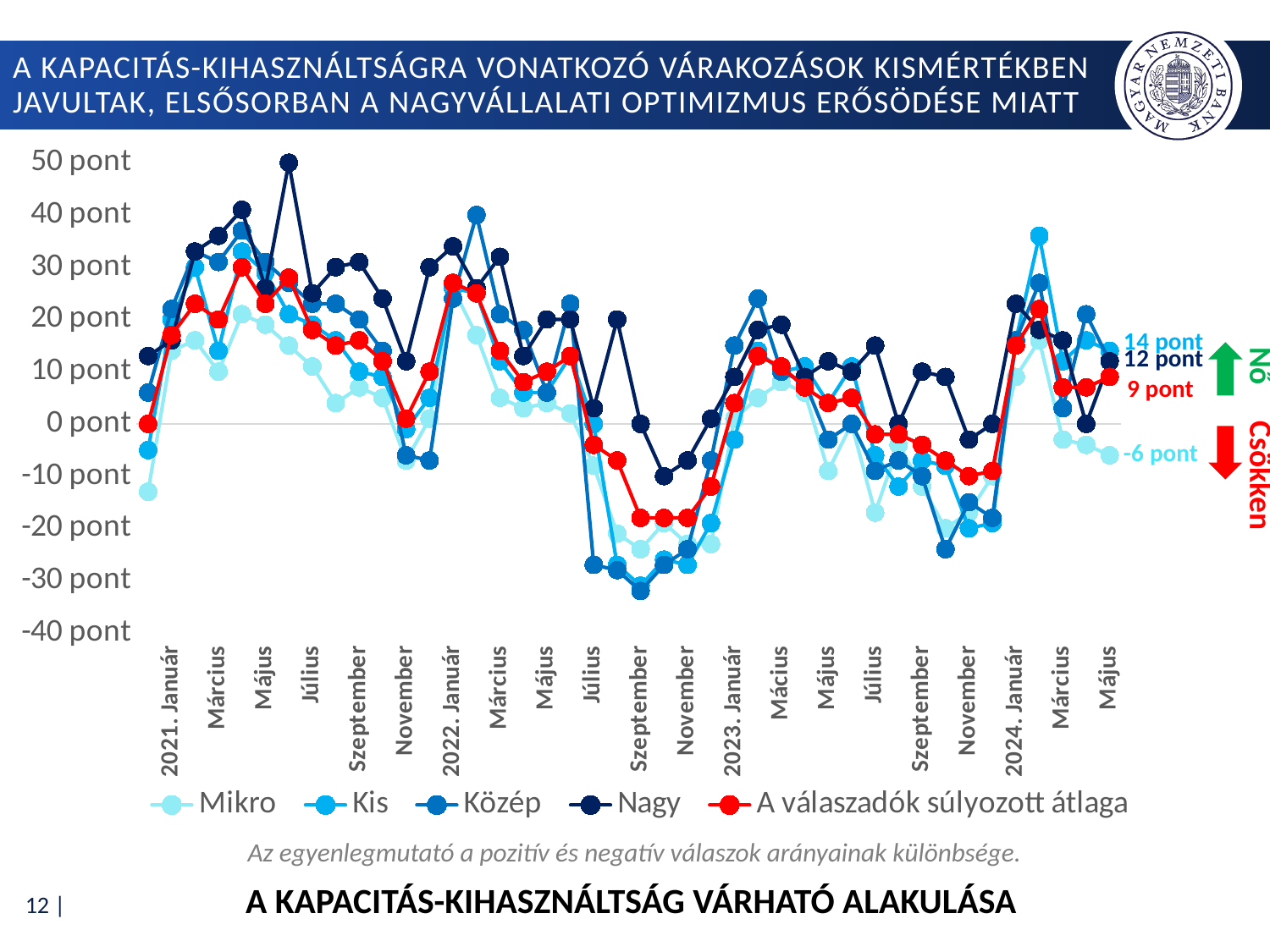
In 2021. Január, which series has the higher value: Nagy or Mikro? Nagy What kind of chart is shown on the slide? line chart What is the final labelled value of the 'A válaszadók súlyozott átlaga' series at the right end of the chart? 9 pont Does the 'A válaszadók súlyozott átlaga' series rise or fall between 2024. Január and Május 2024? fall What is the final labelled value of the Nagy series at the right end of the chart? 12 pont Is the value of the Nagy series in 2024. Január greater or less than 20 pont? greater What is the title of the chart shown at the bottom of the slide? A KAPACITÁS-KIHASZNÁLTSÁG VÁRHATÓ ALAKULÁSA What is the final labelled value of the Mikro series at the right end of the chart? -6 pont Is the value of the 'A válaszadók súlyozott átlaga' series in Szeptember 2022 greater or less than -10 pont? less How many series does the legend list? 5 Which series has the lowest value at the right end of the chart (Május 2024)? Mikro Which series is drawn in red in the chart? A válaszadók súlyozott átlaga